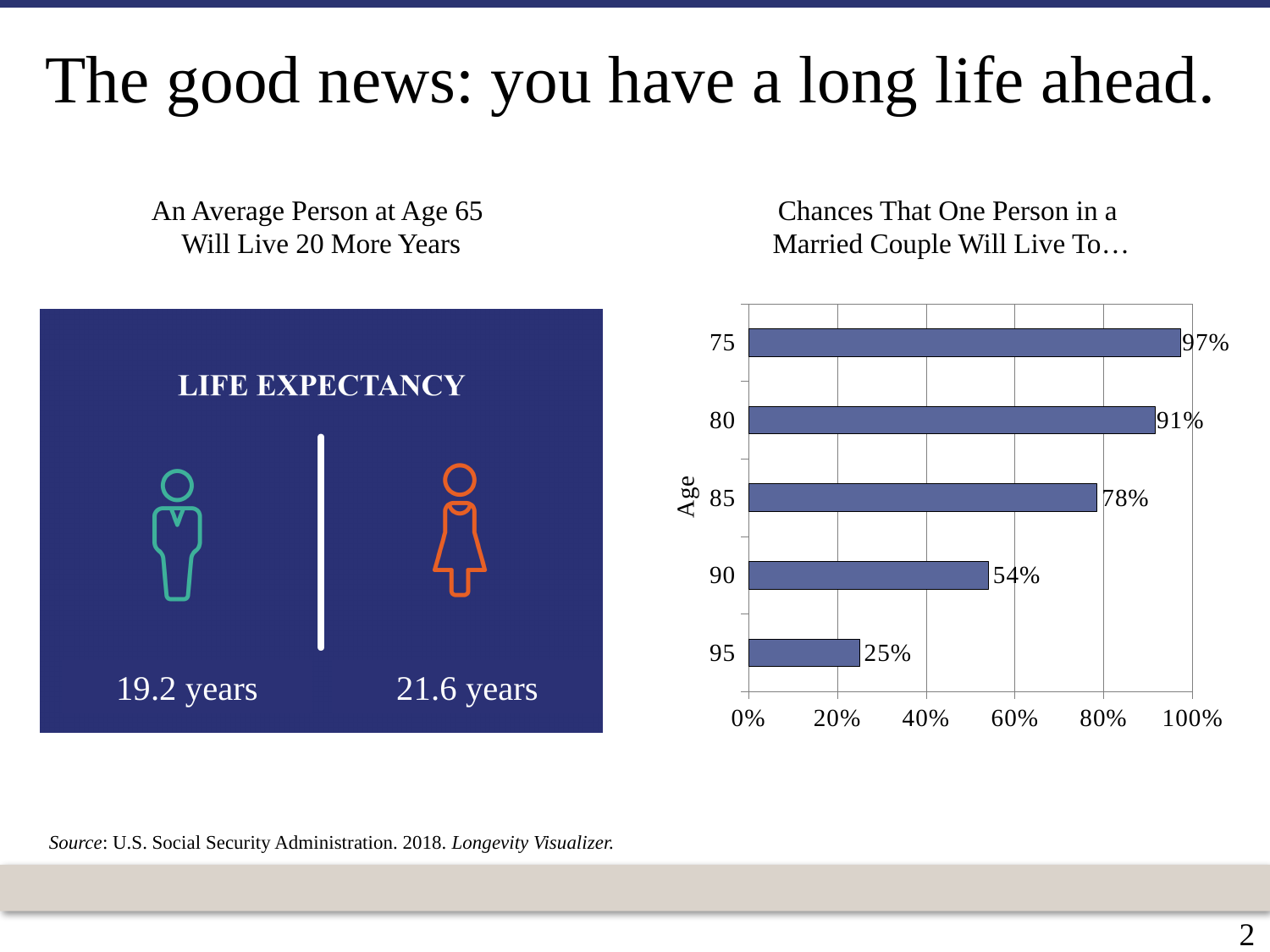
In the chart 'Chances That One Person in a Married Couple Will Live To…', what is the value for age 80? 91% What is the label on the vertical axis of the chart 'Chances That One Person in a Married Couple Will Live To…'? Age In the chart 'Chances That One Person in a Married Couple Will Live To…', which is larger, the value for age 80 or the value for age 90? age 80 How many age categories are shown in the chart 'Chances That One Person in a Married Couple Will Live To…'? 5 In the chart 'Chances That One Person in a Married Couple Will Live To…', which age has the lowest value? 95 In the chart 'Chances That One Person in a Married Couple Will Live To…', what is the difference between the values for age 75 and age 85? 19% In the chart 'Chances That One Person in a Married Couple Will Live To…', what is the value for age 95? 25% In the chart 'Chances That One Person in a Married Couple Will Live To…', is the value for age 90 greater or less than 60%? less In the chart 'Chances That One Person in a Married Couple Will Live To…', what is the value for age 85? 78% In the chart 'Chances That One Person in a Married Couple Will Live To…', what is the difference between the values for age 90 and age 95? 29% In the chart 'Chances That One Person in a Married Couple Will Live To…', which age has the highest value? 75 What kind of chart is 'Chances That One Person in a Married Couple Will Live To…'? bar chart